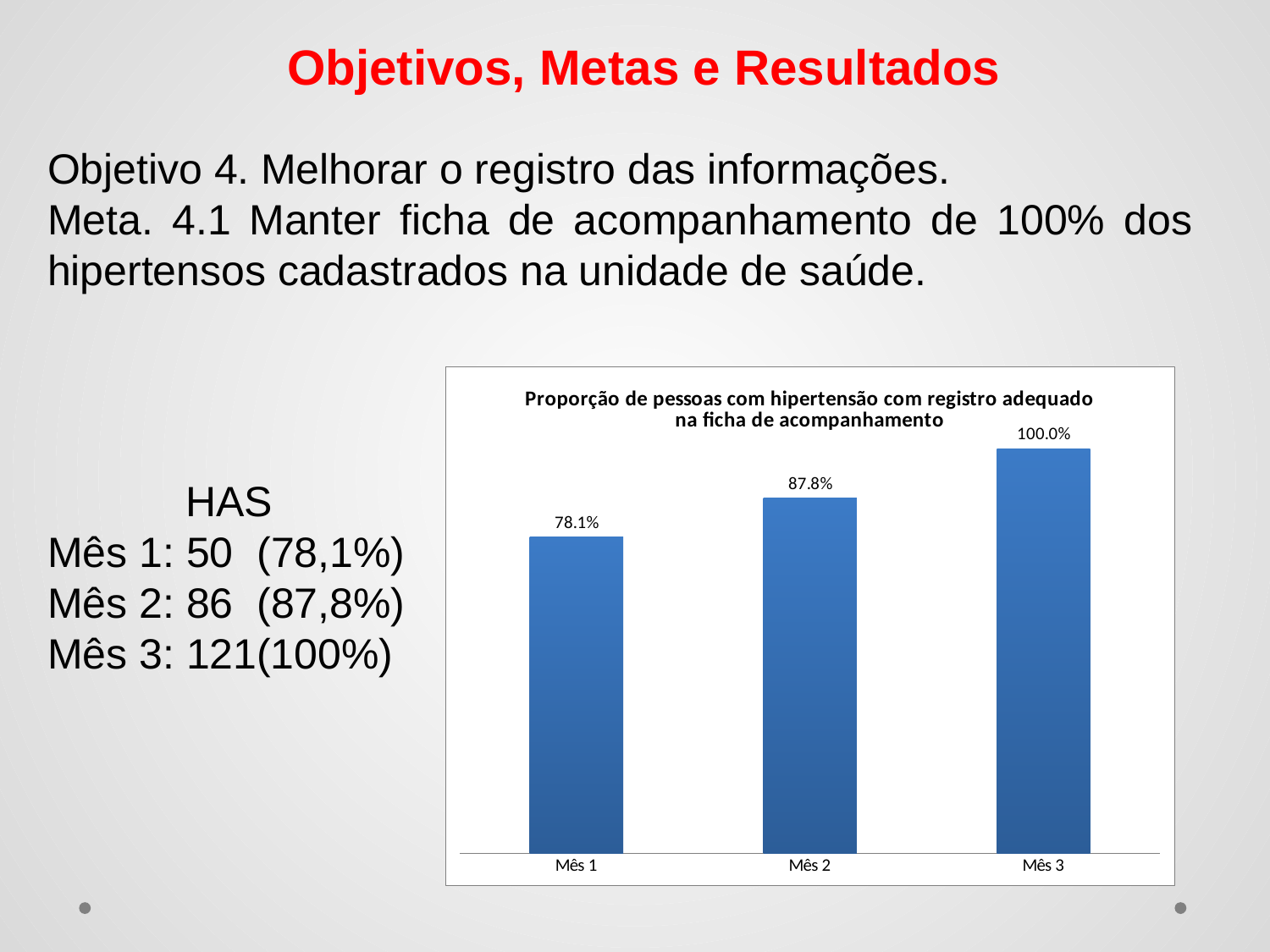
What is the title of the chart? Proporção de pessoas com hipertensão com registro adequado na ficha de acompanhamento What is the difference between the values for Mês 3 and Mês 1? 21.9% Which month has the lowest value? Mês 1 Do the values rise or fall from Mês 1 to Mês 3? Rise What is the value for Mês 3? 100.0% What kind of chart is this? Bar chart What is the value for Mês 1? 78.1% Which is larger, the value for Mês 1 or the value for Mês 2? Mês 2 How many categories are shown on the x axis? 3 What is the value for Mês 2? 87.8% What is the difference between the values for Mês 2 and Mês 1? 9.7% Which month has the highest value? Mês 3